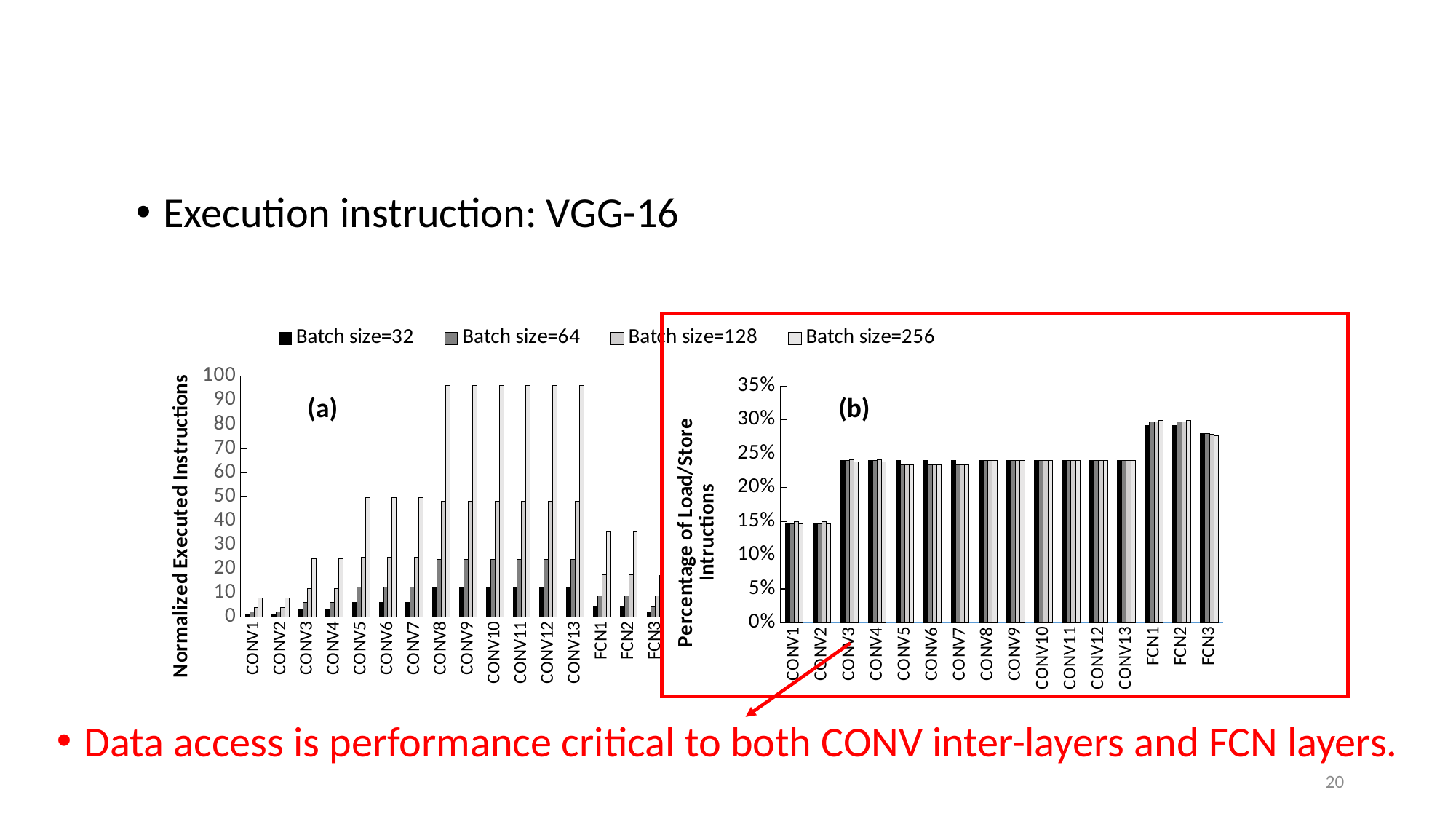
What kind of chart is chart (a), Normalized Executed Instructions? bar chart In chart (a), Normalized Executed Instructions, which is larger for Batch size=256: CONV3 or CONV8? CONV8 What is the y-axis title of chart (b)? Percentage of Load/Store Intructions In chart (b), Percentage of Load/Store Instructions, which is larger for Batch size=32: CONV2 or FCN2? FCN2 In chart (b), Percentage of Load/Store Instructions, is the Batch size=32 value for CONV1 greater or less than 20%? less In chart (a), Normalized Executed Instructions, is the Batch size=256 value for CONV8 greater or less than 90? greater How many layer categories are shown on the x axis of chart (b), Percentage of Load/Store Instructions? 16 In chart (a), Normalized Executed Instructions, is the Batch size=256 value for CONV1 greater or less than 10? less In chart (a), Normalized Executed Instructions, which batch size series has the tallest bars for CONV8? Batch size=256 How many series does the legend list for the charts on the slide? 4